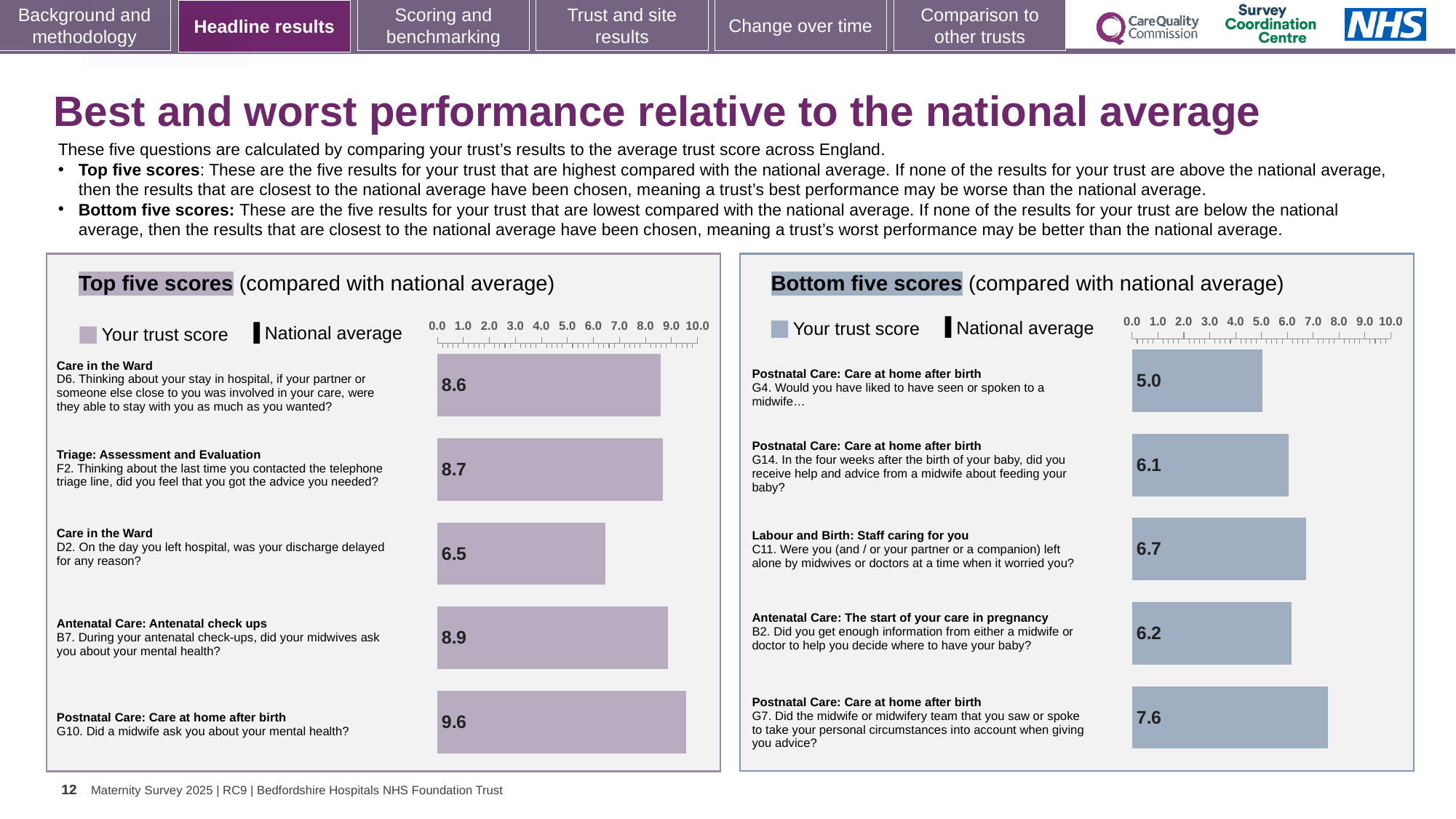
In the Top five scores chart, which question has the highest trust score? G10 (Postnatal Care: Care at home after birth) In the Top five scores chart, what is the trust score for G10 (Did a midwife ask you about your mental health?)? 9.6 How many bars are shown in the Bottom five scores chart? 5 In the Top five scores chart, is the trust score for D2 (was your discharge delayed for any reason?) greater or less than 7.0? less In the Top five scores chart, what is the difference between the trust scores for G10 and D2? 3.1 In the Bottom five scores chart, which has the larger trust score: G7 or C11? G7 In the Bottom five scores chart, what is the trust score for G4 (Would you have liked to have seen or spoken to a midwife…)? 5.0 In the Bottom five scores chart, which question has the lowest trust score? G4 (Postnatal Care: Care at home after birth) What type of chart is used for the Top five scores? Bar chart In the Top five scores chart, what is the trust score for F2 (Triage: Assessment and Evaluation)? 8.7 What two entries does the legend of the Top five scores chart list? Your trust score and National average In the Bottom five scores chart, what is the difference between the trust scores for G7 and G4? 2.6